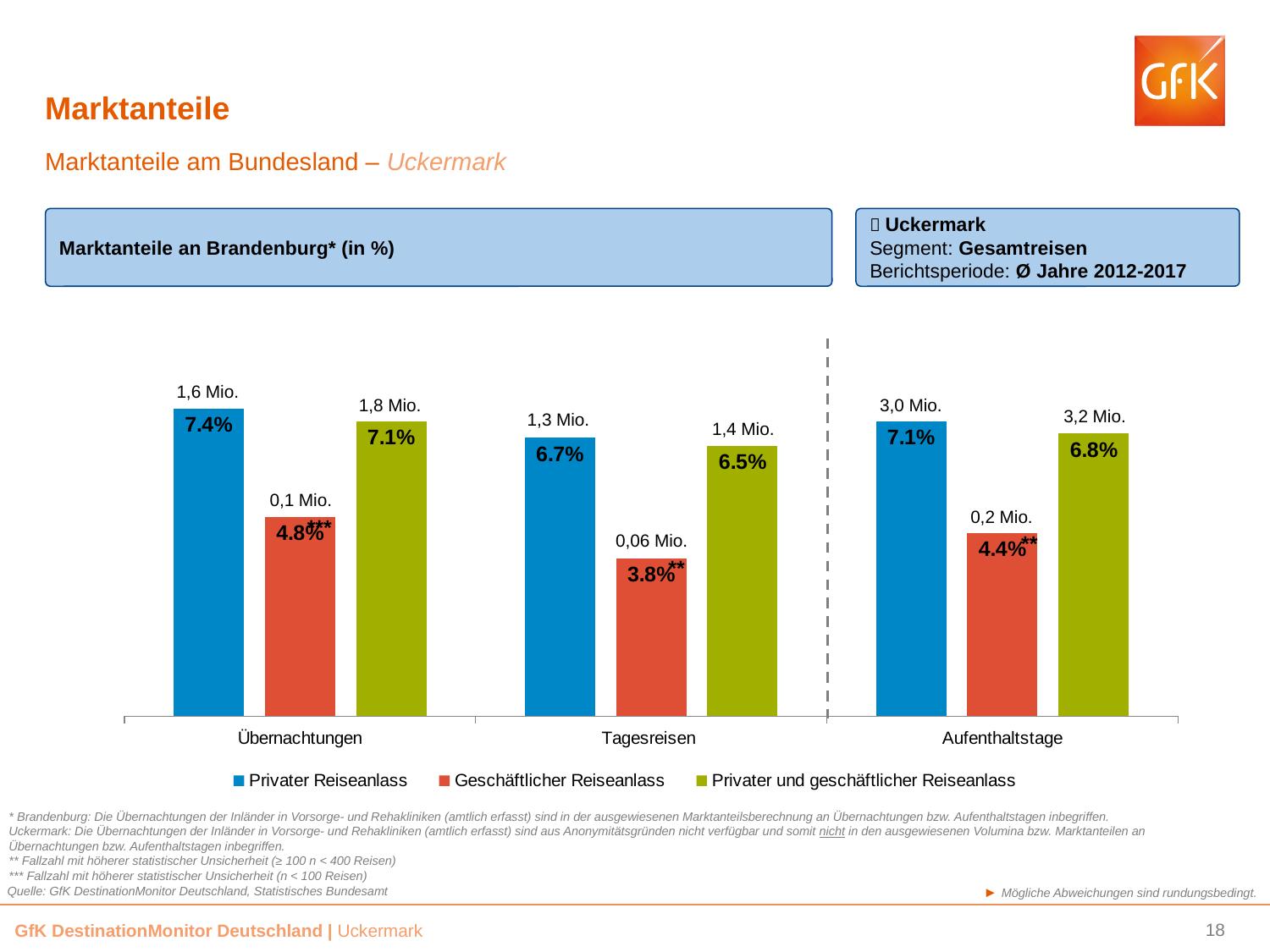
Which series has the lowest market share in the Tagesreisen category? Geschäftlicher Reiseanlass What is the market share for Privater und geschäftlicher Reiseanlass in the Aufenthaltstage category? 6.8% What is the difference between the Privater Reiseanlass share and the Geschäftlicher Reiseanlass share in the Übernachtungen category? 2.6% Which category has the highest market share for Privater Reiseanlass? Übernachtungen How many categories are shown on the x axis of the chart? 3 What volume in Mio. is shown above the Geschäftlicher Reiseanlass bar in the Aufenthaltstage category? 0,2 Mio. What is the market share for Geschäftlicher Reiseanlass in the Tagesreisen category? 3.8% What colour are the Geschäftlicher Reiseanlass bars? Red How many series does the chart legend list? 3 What type of chart is shown on the slide? Bar chart Which is larger in the Aufenthaltstage category: the Privater Reiseanlass share or the Privater und geschäftlicher Reiseanlass share? Privater Reiseanlass What is the market share for Privater Reiseanlass in the Übernachtungen category? 7.4%